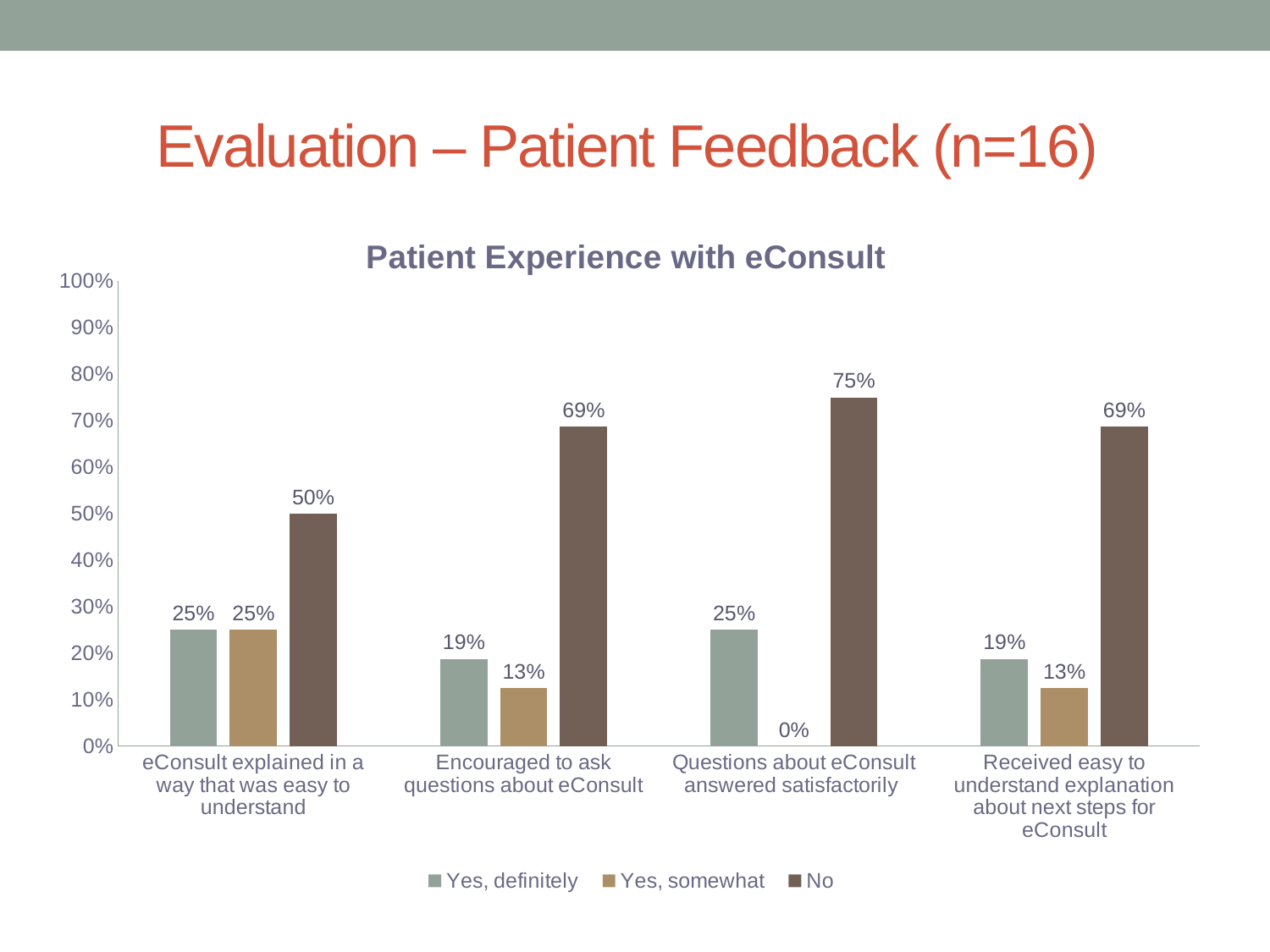
What is the 'Yes, definitely' value for 'eConsult explained in a way that was easy to understand'? 25% How many series does the legend list? 3 What kind of chart is shown on the slide? Bar chart What is the 'Yes, somewhat' value for 'Encouraged to ask questions about eConsult'? 13% Which category has the highest 'No' value? Questions about eConsult answered satisfactorily What is the chart's title? Patient Experience with eConsult What is the difference between the 'No' value and the 'Yes, definitely' value for 'Received easy to understand explanation about next steps for eConsult'? 50% What is the 'No' value for 'Questions about eConsult answered satisfactorily'? 75% Which is larger for 'eConsult explained in a way that was easy to understand': the 'No' value or the 'Yes, definitely' value? No How many categories are shown on the x axis? 4 Which legend entry is shown in the darkest colour? No Which category has the lowest 'Yes, somewhat' value? Questions about eConsult answered satisfactorily